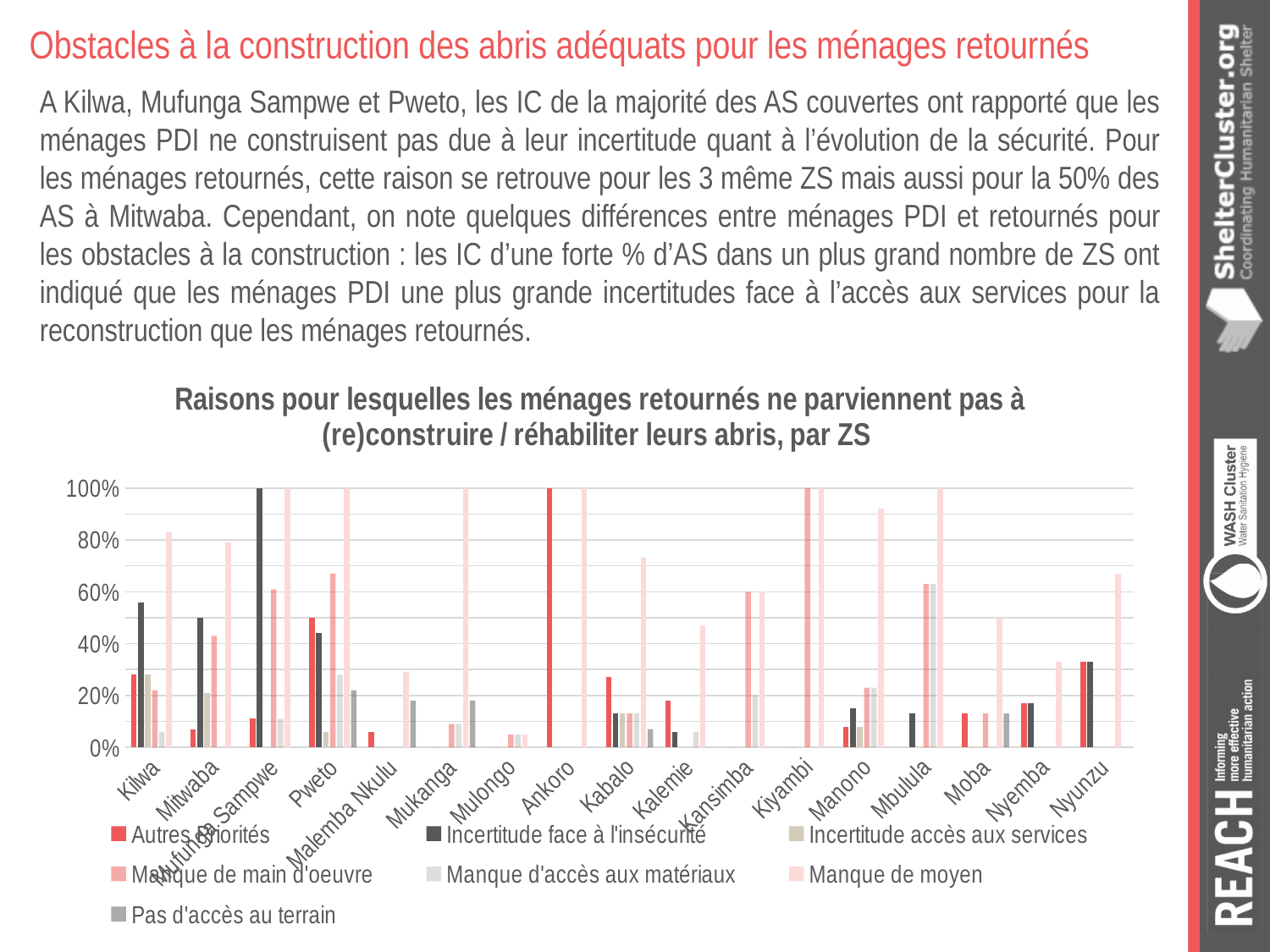
Is the value of 'Manque de moyen' for Kalemie greater or less than 60%? less Which ZS has the highest value for 'Incertitude face à l'insécurité'? Mufunga Sampwe What is the value of 'Incertitude face à l'insécurité' for Mufunga Sampwe? 100% Is the value of 'Manque de moyen' for Manono greater or less than 80%? greater What is the title of the chart? Raisons pour lesquelles les ménages retournés ne parviennent pas à (re)construire / réhabiliter leurs abris, par ZS What kind of chart is shown on the slide? bar chart Is the value of 'Incertitude face à l'insécurité' for Kilwa greater or less than 40%? greater Which is larger: 'Manque de moyen' for Kilwa or 'Manque de moyen' for Kalemie? Kilwa How many series does the chart legend list? 7 What is the value of 'Autres priorités' for Ankoro? 100% Which ZS has the highest value for 'Autres priorités'? Ankoro How many ZS (categories) are shown on the x axis of the chart? 17